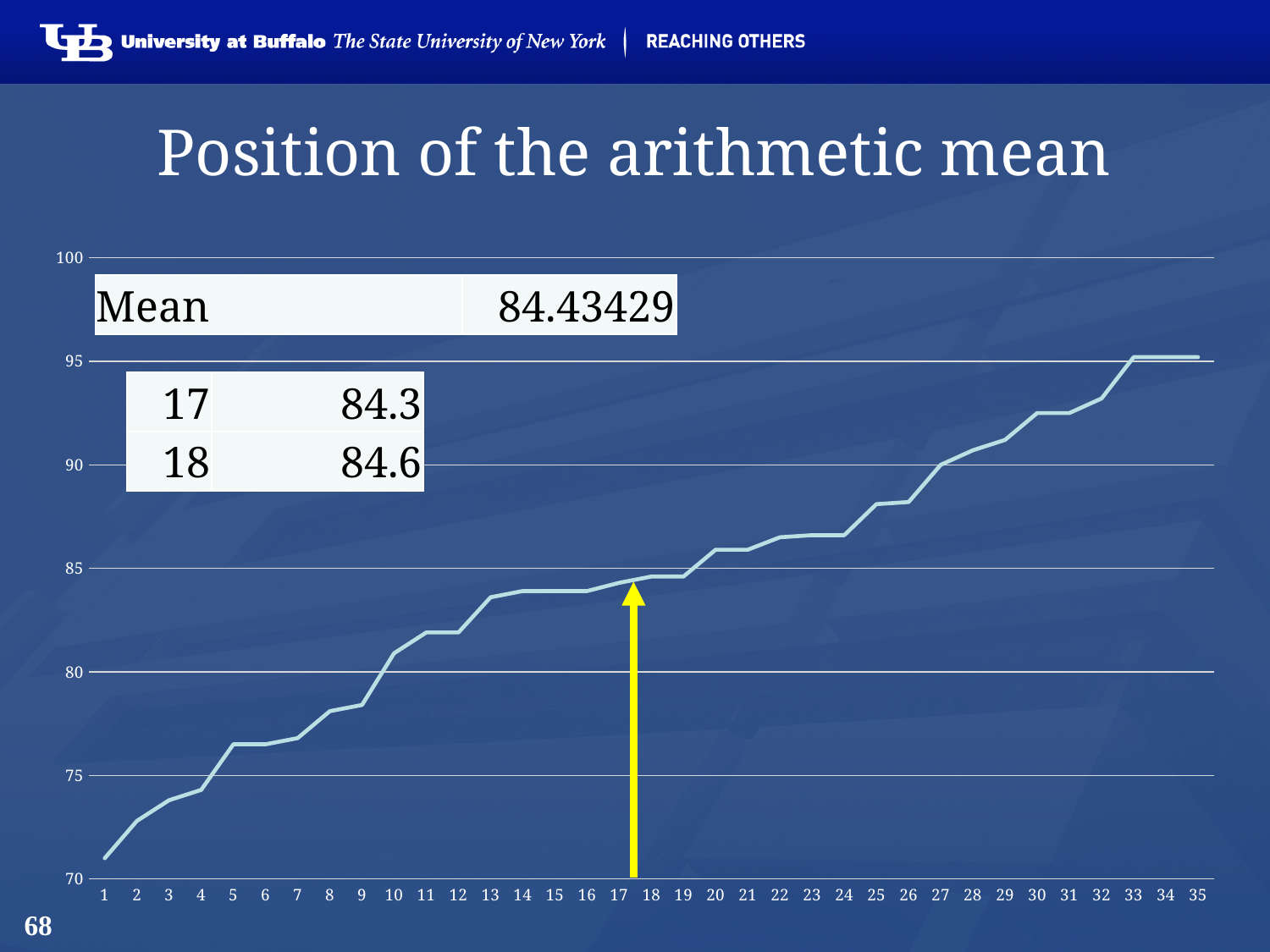
Is the value at position 1 greater or less than 75? less What is the value at position 17? 84.3 How many points are plotted along the x axis? 35 Is the value at position 25 greater or less than 85? greater Is the value at position 10 greater or less than 80? greater Which has the larger value, position 17 or position 18? 18 What is the value at position 18? 84.6 What mean value is shown in the box on the chart? 84.43429 Do the plotted values rise or fall as the x axis goes from 1 to 35? rise What is the difference between the values at positions 18 and 17? 0.3 Which position has the lowest value? 1 What kind of chart is shown on the slide? line chart